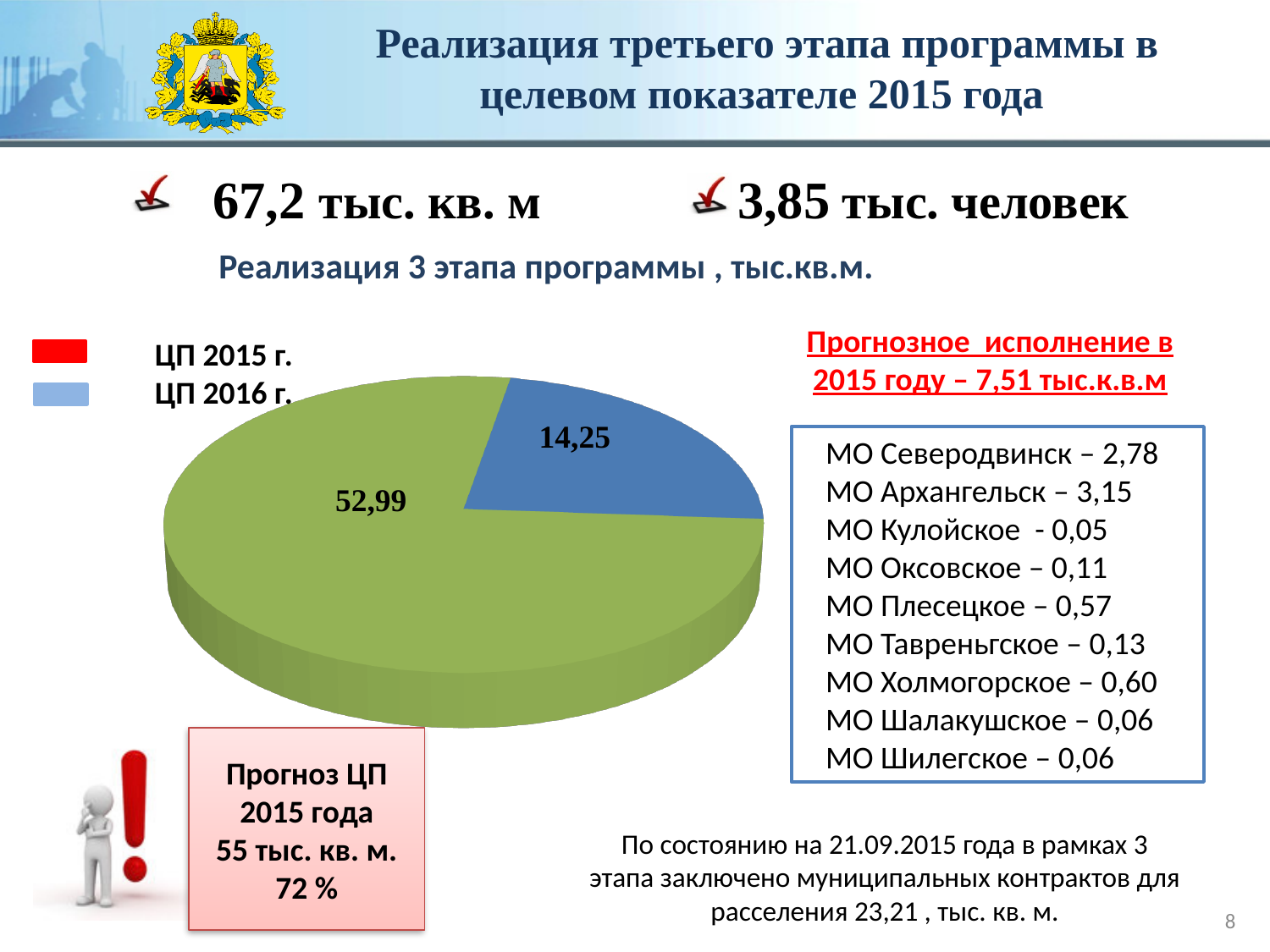
How many slices does the pie chart have? 2 What are the two legend entries shown next to the pie chart? ЦП 2015 г. and ЦП 2016 г. What type of chart is shown on the slide? pie chart What value is shown on the green slice of the pie chart? 52,99 What is the difference between the two slice values in the pie chart (52,99 and 14,25)? 38,74 What value is shown on the blue slice of the pie chart? 14,25 How many entries does the legend next to the pie chart list? 2 What is the value of the smallest slice in the pie chart? 14,25 Which slice of the pie chart is larger, the green one or the blue one? the green one What is the total of the two slice values shown in the pie chart? 67,24 What is the title of the chart on the slide? Реализация 3 этапа программы , тыс.кв.м. What is the value of the largest slice in the pie chart? 52,99